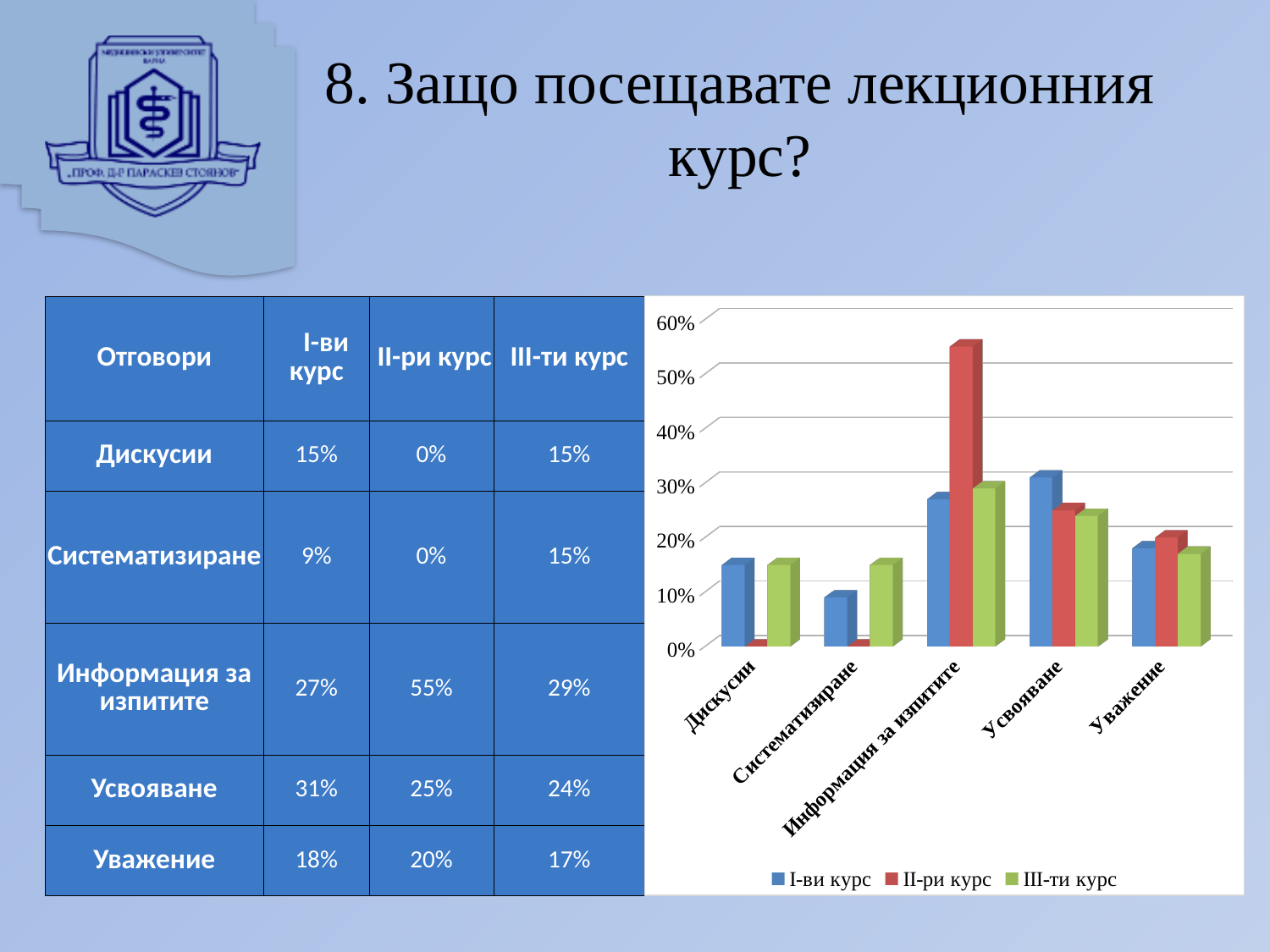
Which category has the lowest value for the I-ви курс series? Систематизиране What is the difference between the II-ри курс and I-ви курс values for Информация за изпитите? 28% What is the value for I-ви курс in the category Усвояване? 31% Is the value for II-ри курс in Информация за изпитите greater or less than 50%? greater What kind of chart is shown on the slide? bar chart How many series does the chart legend list? 3 What colour are the bars for the II-ри курс series? red How many categories are shown on the x axis of the chart? 5 Which is larger for Усвояване: the I-ви курс value or the II-ри курс value? I-ви курс Is the value for III-ти курс in Дискусии greater or less than 20%? less What is the value for II-ри курс in the category Информация за изпитите? 55% Which category has the highest value for the II-ри курс series? Информация за изпитите